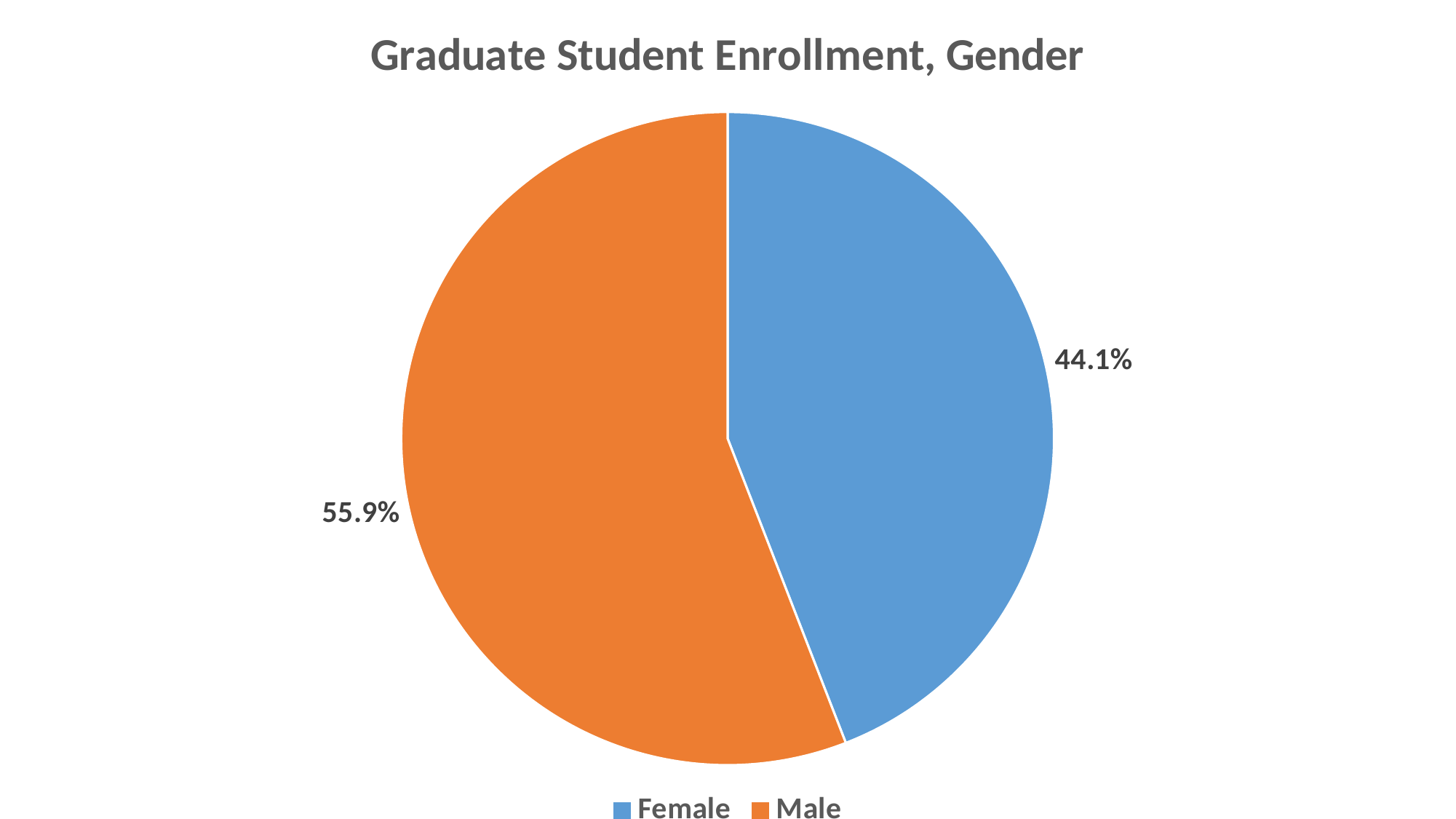
What is the difference in percentage points between the Male and Female shares? 11.8 What kind of chart is shown on the slide? Pie chart What is the title of the chart? Graduate Student Enrollment, Gender Is the Female share greater or less than 50%? less How many entries does the legend list? 2 Which gender has the smaller share of graduate student enrollment? Female How many slices does the pie chart have? 2 Which colour represents Female in the chart? Blue What share of graduate student enrollment is Female? 44.1% Which gender has the larger share of graduate student enrollment? Male What share of graduate student enrollment is Male? 55.9% Is the Male share larger than the Female share? Yes